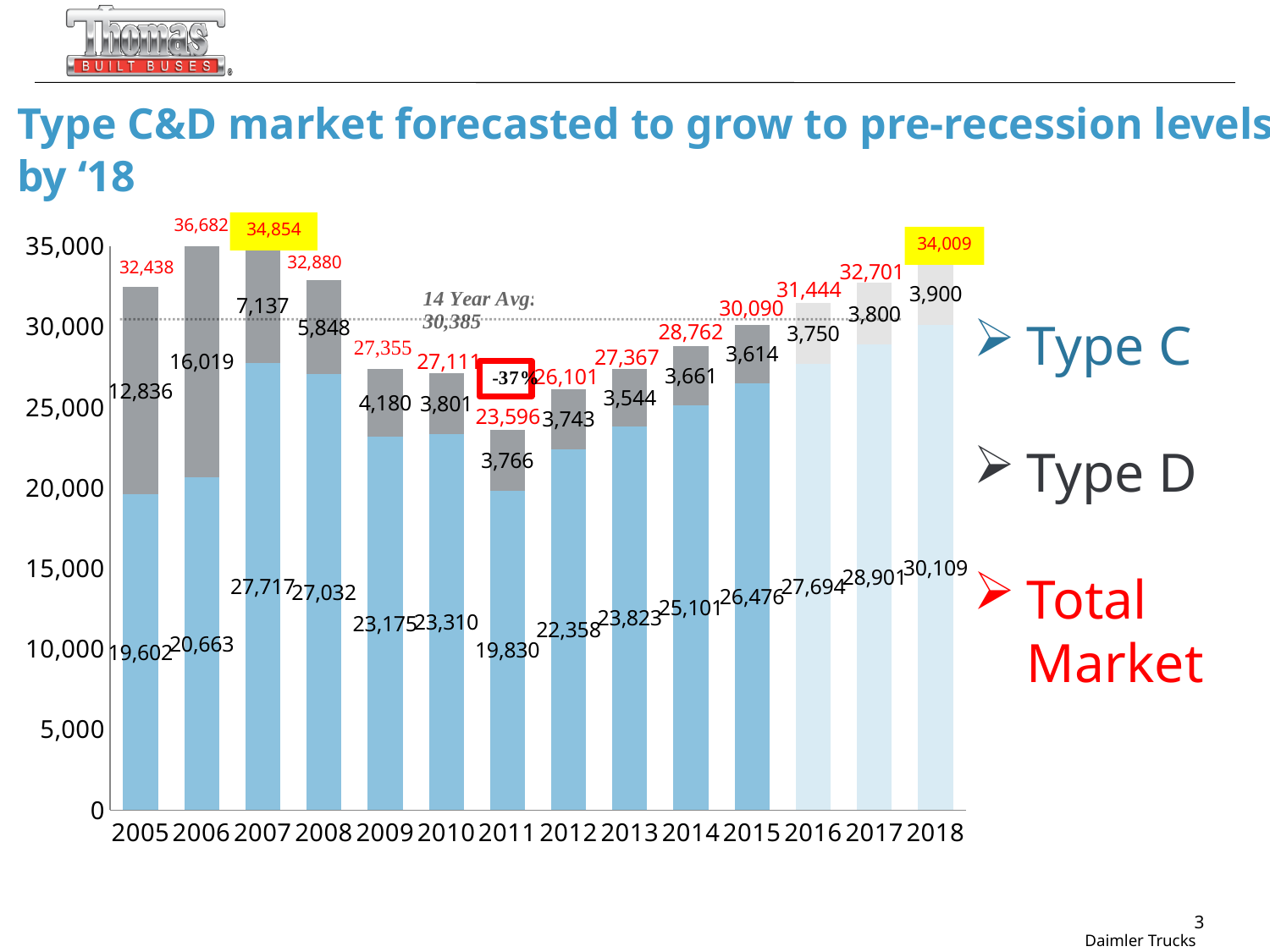
Which year has the highest Total Market value? 2006 How many series does the legend list? 3 What is the Type D value for 2006? 16,019 What is the difference between the Type C values for 2018 and 2005? 10,507 What is the 14 Year Avg value shown by the dotted line? 30,385 What is the Type C value for 2011? 19,830 What kind of chart is shown on the slide? Stacked bar chart What is the Total Market value for 2018? 34,009 Do the Type C values rise or fall from 2011 to 2018? Rise Which year has the lowest Total Market value? 2011 How many years are shown on the x axis? 14 Which is larger, the Type D value for 2007 or for 2008? 2007